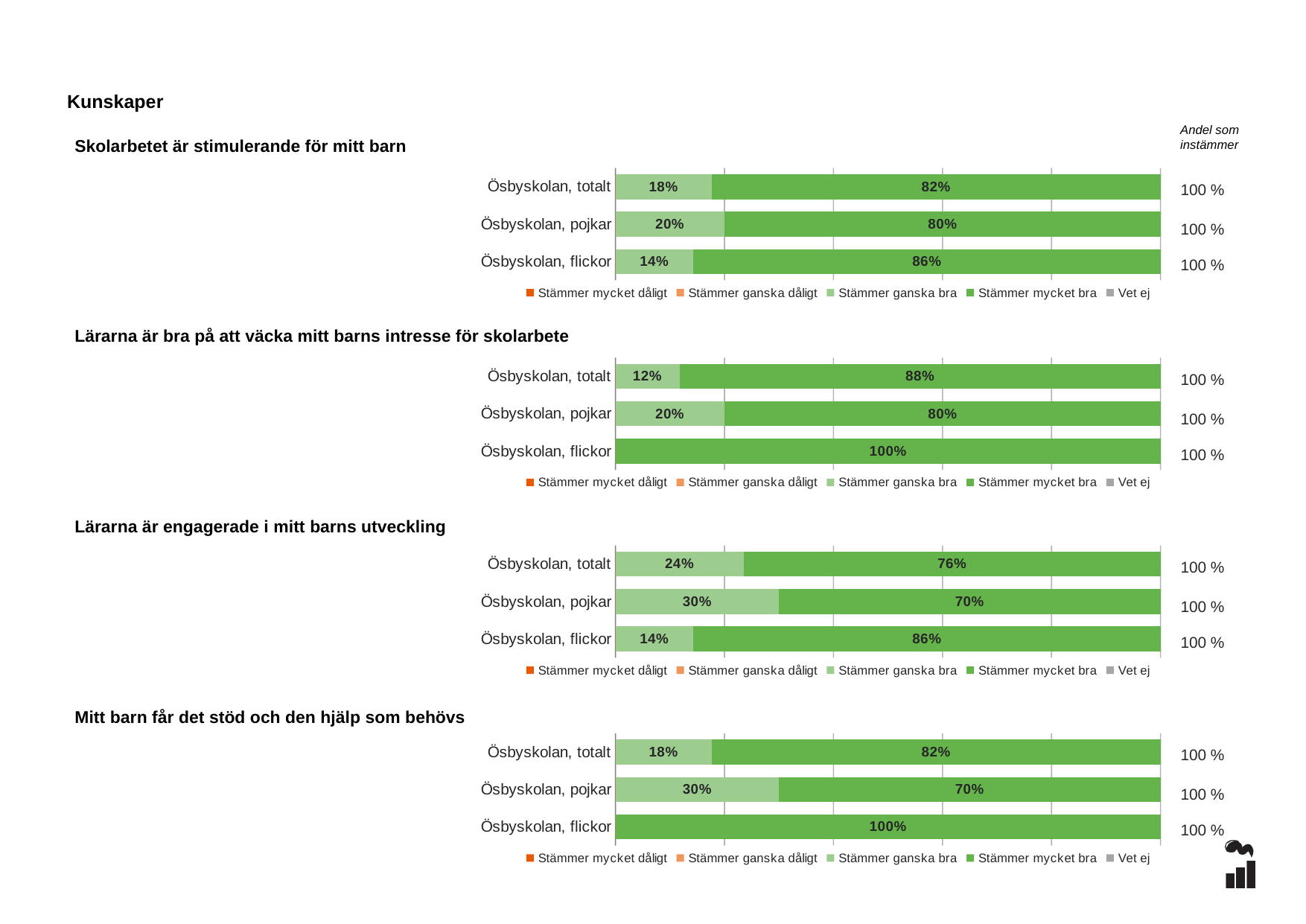
In the chart 'Lärarna är engagerade i mitt barns utveckling', which category has the lowest 'Stämmer mycket bra' value? Ösbyskolan, pojkar In the chart 'Skolarbetet är stimulerande för mitt barn', what is the 'Stämmer ganska bra' value for Ösbyskolan, pojkar? 20% In the chart 'Lärarna är engagerade i mitt barns utveckling', what is the total of the stacked bar for Ösbyskolan, totalt? 100% In the chart 'Lärarna är bra på att väcka mitt barns intresse för skolarbete', which category has the highest 'Stämmer mycket bra' value? Ösbyskolan, flickor How many series does the legend list for the chart 'Lärarna är engagerade i mitt barns utveckling'? 5 In the chart 'Skolarbetet är stimulerande för mitt barn', what is the 'Stämmer mycket bra' value for Ösbyskolan, flickor? 86% How many categories are shown in the chart 'Skolarbetet är stimulerande för mitt barn'? 3 In the chart 'Mitt barn får det stöd och den hjälp som behövs', which is larger: the 'Stämmer mycket bra' value for Ösbyskolan, totalt or for Ösbyskolan, pojkar? Ösbyskolan, totalt In the chart 'Lärarna är engagerade i mitt barns utveckling', what is the difference between the 'Stämmer ganska bra' values for Ösbyskolan, pojkar and Ösbyskolan, flickor? 16% In the chart 'Lärarna är bra på att väcka mitt barns intresse för skolarbete', what is the 'Stämmer mycket bra' value for Ösbyskolan, totalt? 88% In the chart 'Mitt barn får det stöd och den hjälp som behövs', what is the 'Stämmer ganska bra' value for Ösbyskolan, pojkar? 30% What kind of chart is 'Mitt barn får det stöd och den hjälp som behövs'? Stacked bar chart